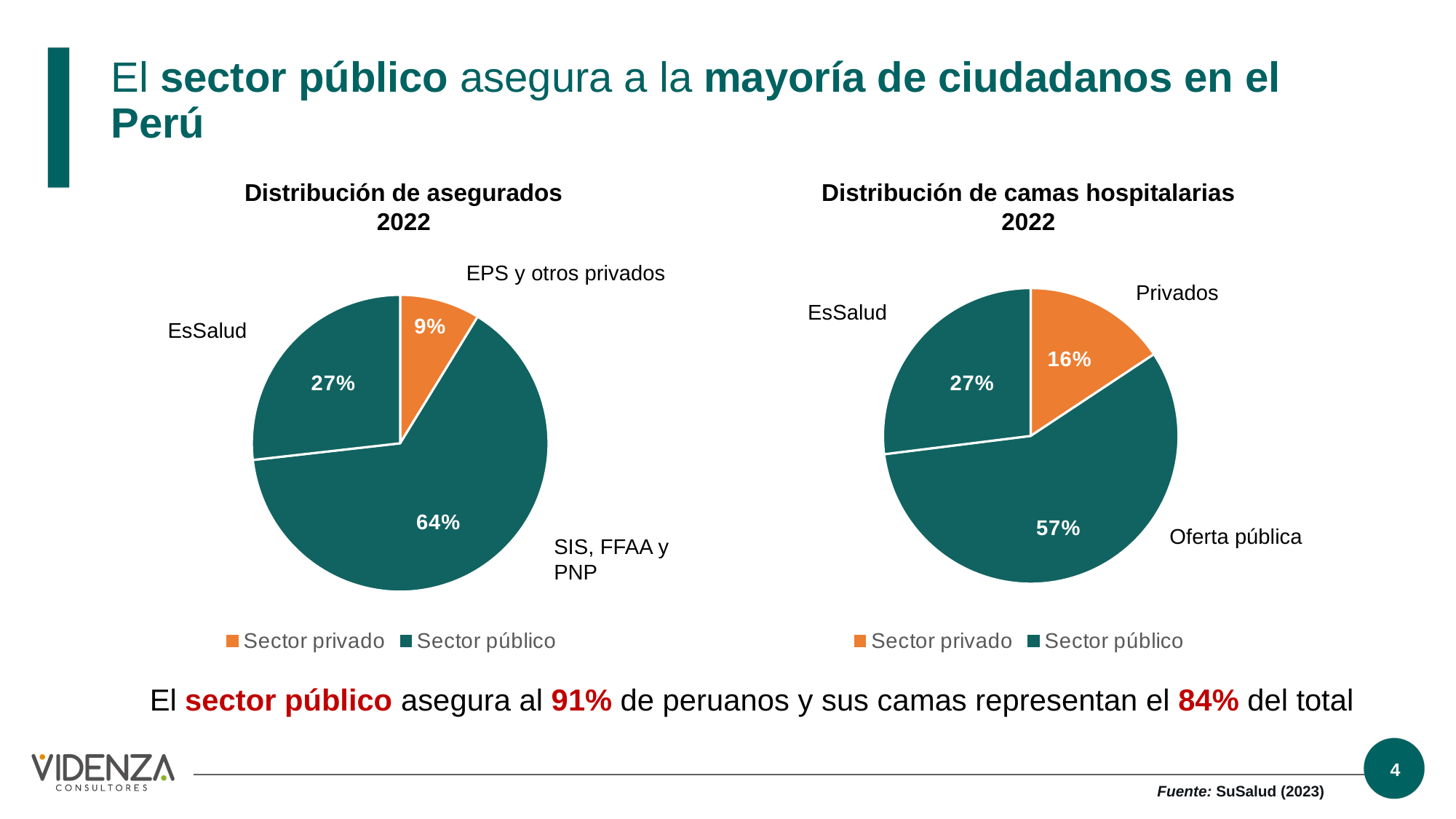
What type of chart is 'Distribución de asegurados 2022'? Pie chart In the 'Distribución de camas hospitalarias 2022' chart, which slice is the smallest? Privados How many slices does the 'Distribución de camas hospitalarias 2022' chart have? 3 In the 'Distribución de camas hospitalarias 2022' chart, what is the difference between Oferta pública and EsSalud? 30 percentage points In the 'Distribución de asegurados 2022' chart, what share does EsSalud have? 27% In the 'Distribución de asegurados 2022' chart, what share does SIS, FFAA y PNP have? 64% In the 'Distribución de asegurados 2022' chart, which slice is the largest? SIS, FFAA y PNP In the 'Distribución de asegurados 2022' chart, which is larger: EsSalud or EPS y otros privados? EsSalud How many entries does the legend of the 'Distribución de camas hospitalarias 2022' chart list? 2 In the 'Distribución de camas hospitalarias 2022' chart, what share does Privados have? 16% In the 'Distribución de asegurados 2022' chart, what share does EPS y otros privados have? 9% In the 'Distribución de camas hospitalarias 2022' chart, what share does Oferta pública have? 57%